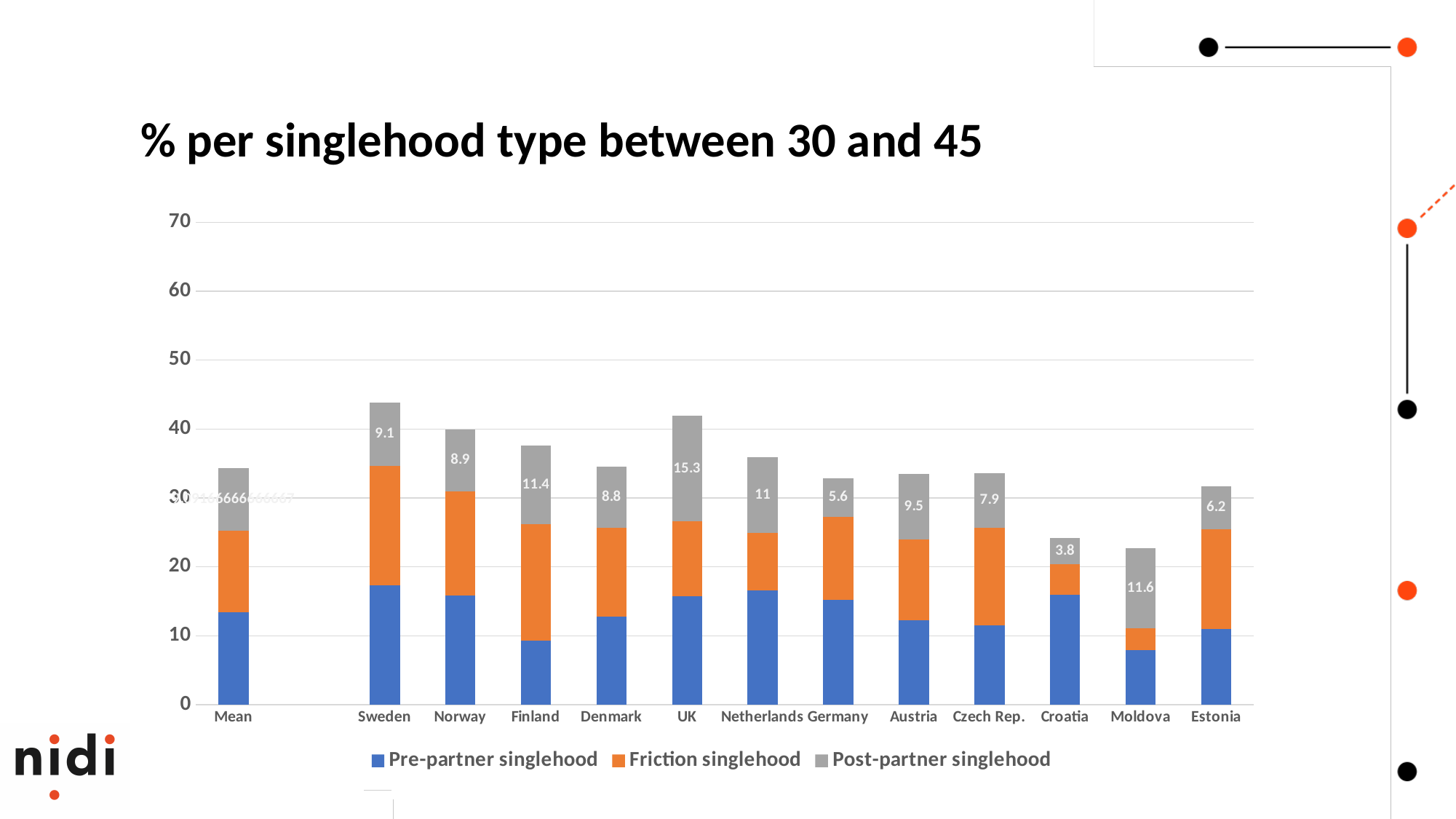
How many categories are shown on the x axis? 13 What is the difference between the Post-partner singlehood values for the UK and Croatia? 11.5 Which country has the highest labelled Post-partner singlehood value? UK What is the Post-partner singlehood value for the UK? 15.3 How many series does the legend list? 3 What type of chart is shown on the slide? Stacked bar chart Which country has the lowest labelled Post-partner singlehood value? Croatia What is the Post-partner singlehood value for Croatia? 3.8 Which has a larger Post-partner singlehood value, Sweden or Germany? Sweden Is the total stacked value for Sweden greater or less than 40? greater What is the Post-partner singlehood value for Moldova? 11.6 Is the total stacked value for Moldova greater or less than 30? less